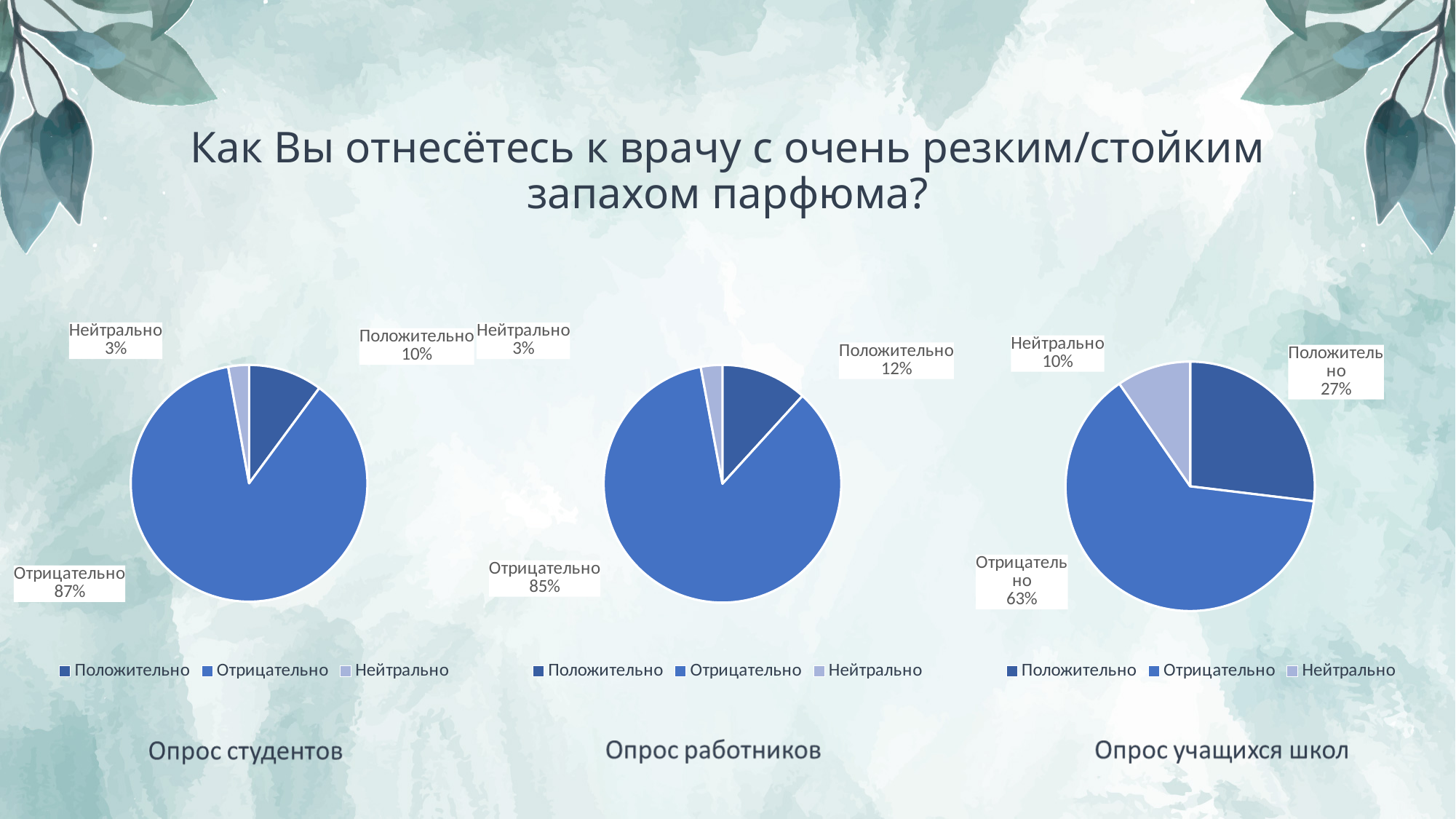
In the 'Опрос учащихся школ' pie chart, what share is labelled 'Отрицательно'? 63% In the 'Опрос работников' pie chart, what share is labelled 'Положительно'? 12% Which is larger: the 'Положительно' share in 'Опрос работников' or the 'Положительно' share in 'Опрос учащихся школ'? Опрос учащихся школ In the 'Опрос работников' pie chart, what share is labelled 'Нейтрально'? 3% In the 'Опрос студентов' pie chart, what share is labelled 'Положительно'? 10% In the 'Опрос учащихся школ' pie chart, which category has the largest slice? Отрицательно How many entries does the legend of the 'Опрос студентов' chart list? 3 What type of chart is used for 'Опрос работников'? Pie chart In the 'Опрос учащихся школ' pie chart, what is the difference between the 'Отрицательно' and 'Положительно' shares? 36 percentage points In the 'Опрос студентов' pie chart, which category has the smallest slice? Нейтрально In the 'Опрос учащихся школ' pie chart, what share is labelled 'Нейтрально'? 10% In the 'Опрос студентов' pie chart, what share is labelled 'Отрицательно'? 87%